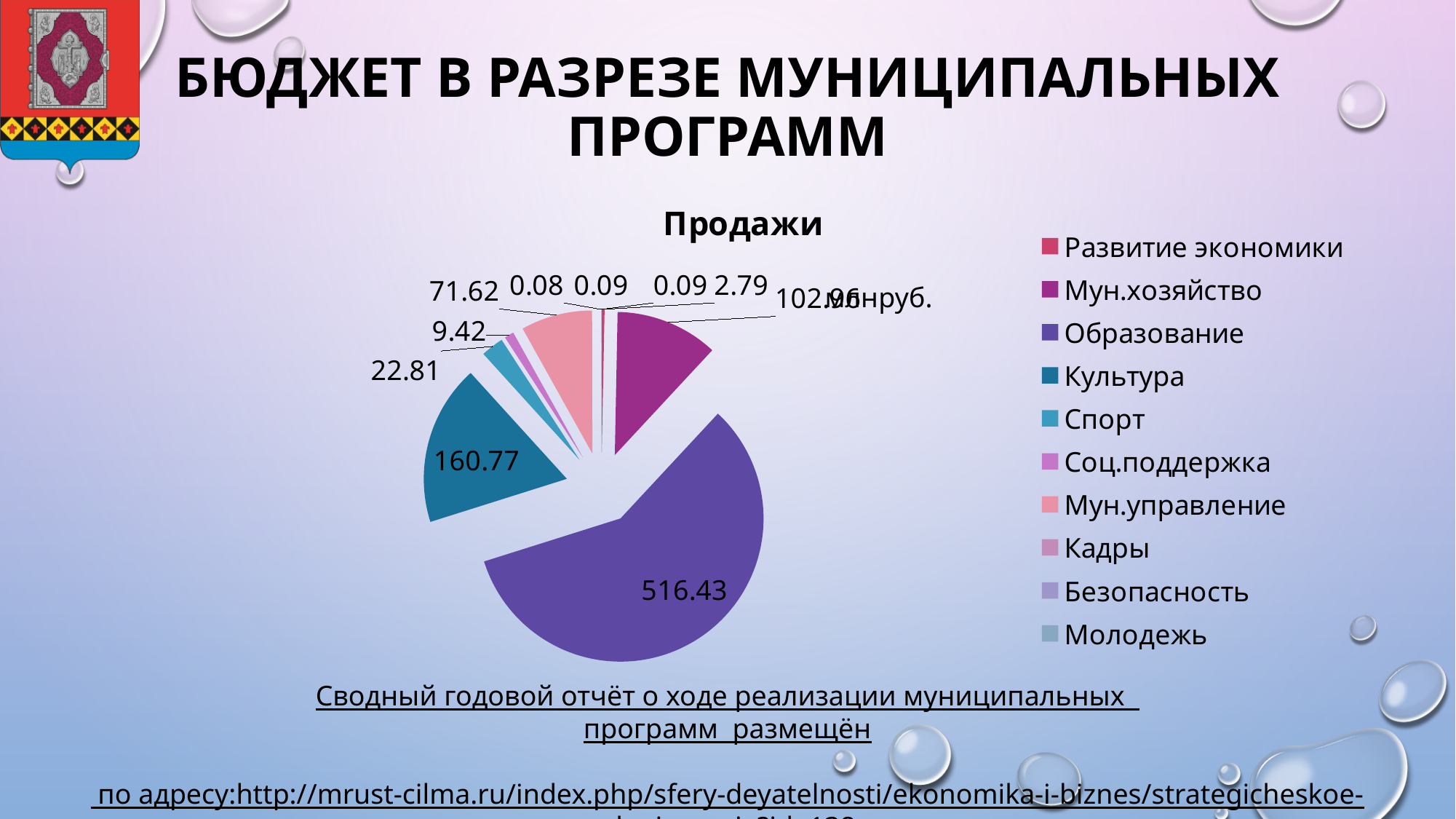
What is the difference between the values for Образование and Культура? 355.66 What is the title of the chart? Продажи What is the value labelled for Мун.управление? 71.62 What is the value labelled for Спорт? 22.81 Which category has the largest slice of the pie? Образование What is the value labelled for Образование? 516.43 What is the value labelled for Соц.поддержка? 9.42 What colour is the Образование slice of the pie? purple What is the value labelled for Культура? 160.77 How many entries does the chart legend list? 10 What kind of chart is shown on the slide? pie chart Which is larger, the value for Культура or the value for Мун.управление? Культура